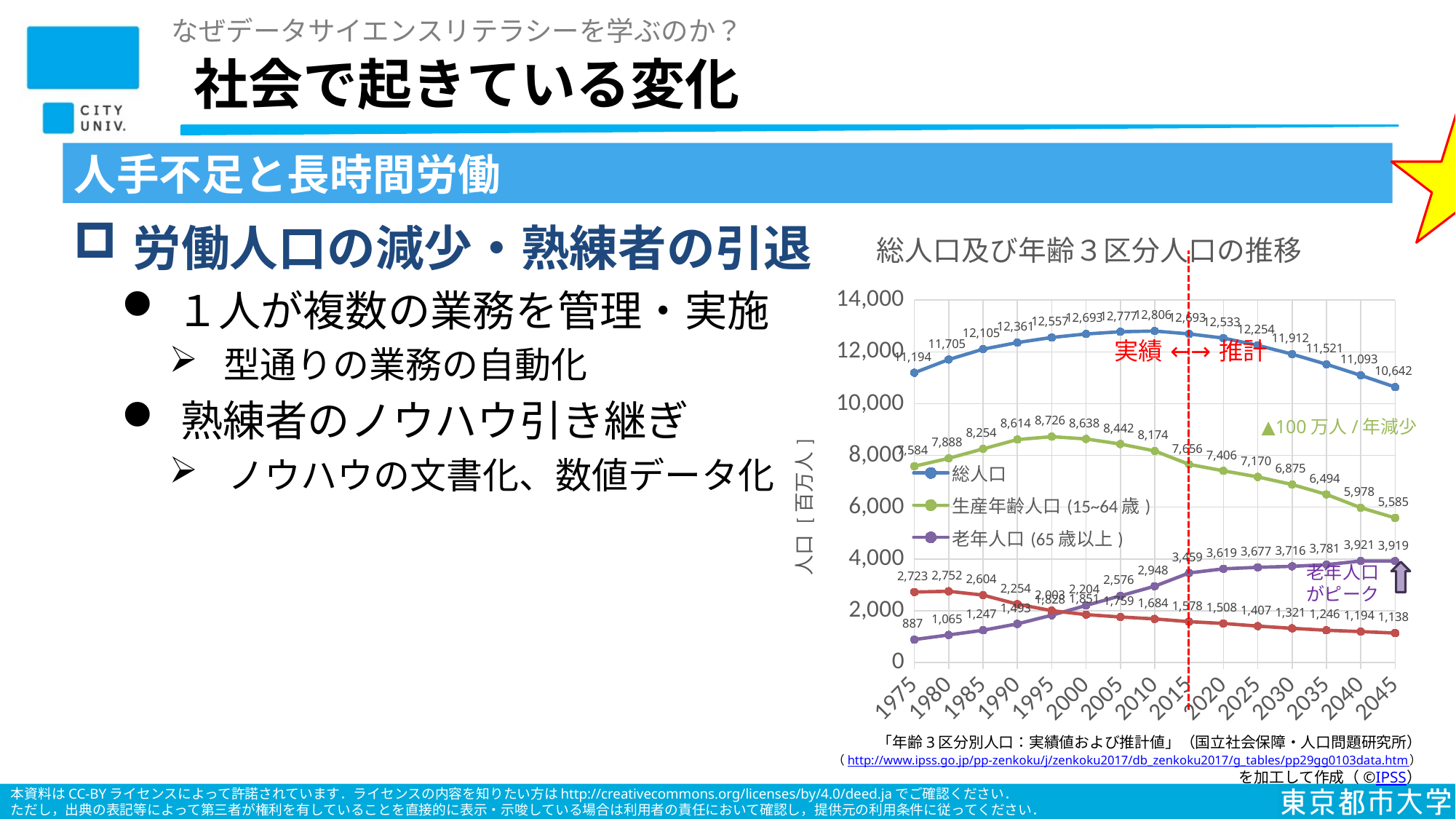
In which year is 老年人口 (65歳以上) at its lowest value? 1975 What is the value of 総人口 in 2010? 12,806 What is the value of 老年人口 (65歳以上) in 2045? 3,919 How many years are plotted on the x axis? 15 What is the difference between 総人口 in 2010 and in 2045? 2,164 Which is larger in 2045: 生産年齢人口 (15~64歳) or 老年人口 (65歳以上)? 生産年齢人口 (15~64歳) Is the value of 総人口 in 2045 greater or less than 12,000? less What is the value of 生産年齢人口 (15~64歳) in 1995? 8,726 In which year does 総人口 reach its highest value? 2010 Does 生産年齢人口 (15~64歳) rise or fall from 2000 to 2045? fall What kind of chart is shown? line chart How many series does the legend list? 3